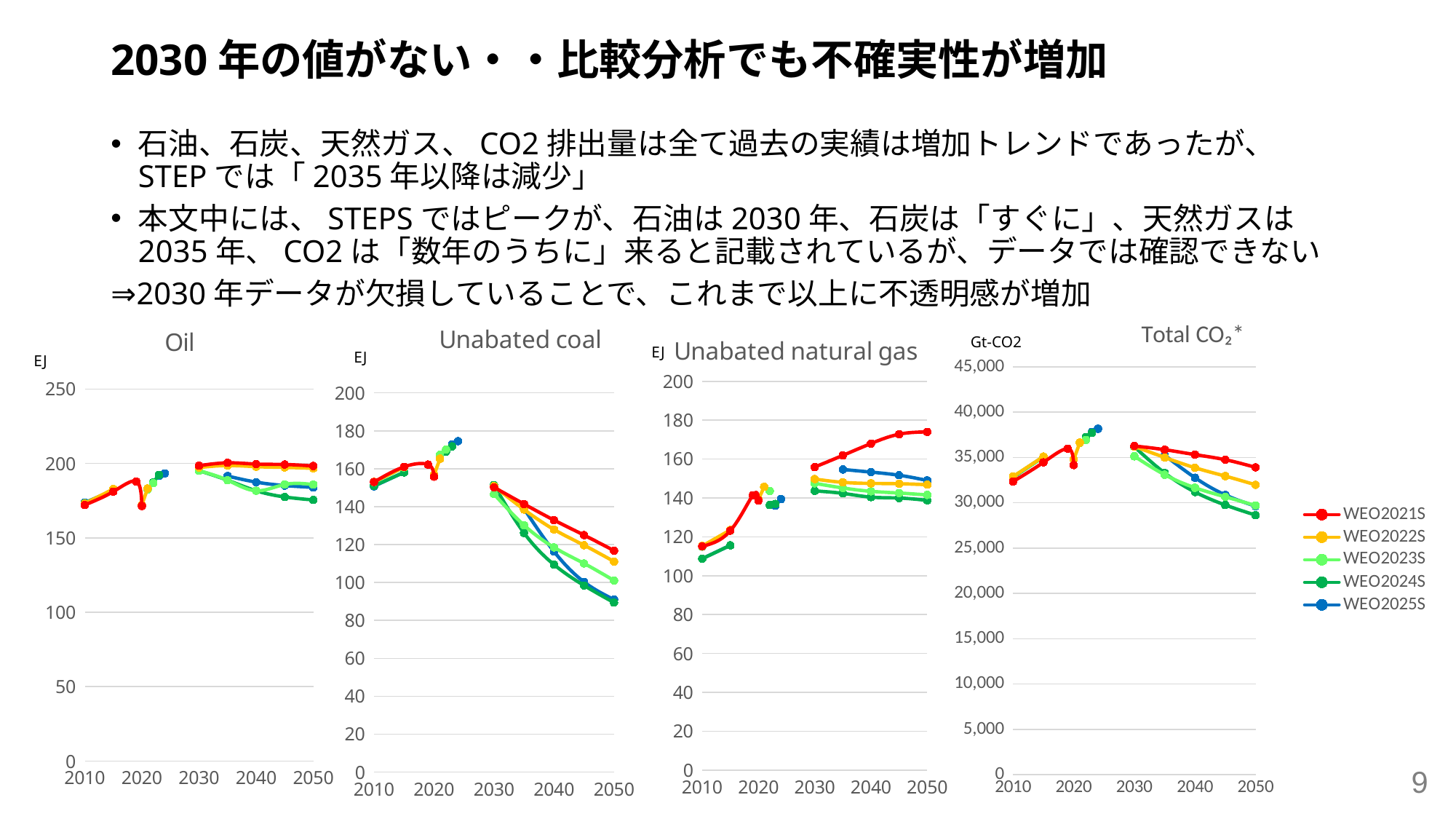
In the Unabated coal chart, is the value for WEO2024S in 2050 greater or less than 100? less In the Unabated natural gas chart, does the WEO2021S line rise or fall from 2030 to 2050? rise What kind of chart is the Oil chart? line chart In the Total CO₂* chart, is the value for WEO2024S in 2050 greater or less than 30,000? less In the Unabated natural gas chart, which is larger in 2050, WEO2021S or WEO2024S? WEO2021S How many series does the legend list for the charts? 5 What is the title of the rightmost chart? Total CO₂* In the Unabated natural gas chart, is the value for WEO2021S in 2050 greater or less than 160? greater In the Total CO₂* chart, which series has the highest value in 2050? WEO2021S What unit is shown on the y axis of the Total CO₂* chart? Gt-CO2 In the Unabated coal chart, does the WEO2021S line rise or fall from 2030 to 2050? fall